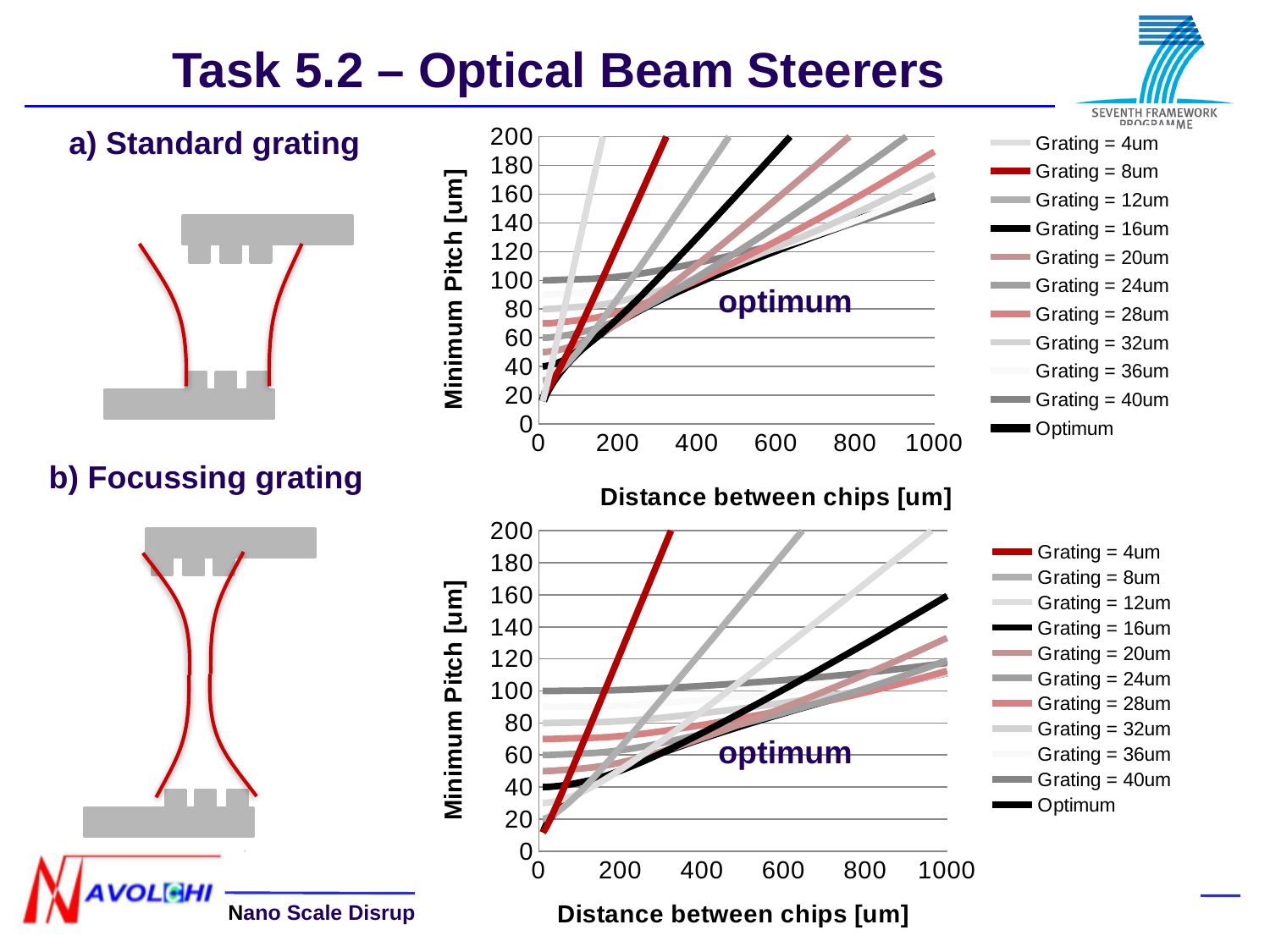
In the top chart, is the value for Grating = 8um at a distance of 200 greater or less than 100? greater In the top chart, does the Optimum line rise or fall as the distance between chips increases? rises What kind of chart is the top chart (Standard grating)? line chart In the bottom chart, is the value for Grating = 4um at a distance of 200 greater or less than 100? greater In the bottom chart, does the Optimum line rise or fall as the distance between chips increases? rises What is the x-axis title of the top chart? Distance between chips [um] In the bottom chart, at a distance of 1000, which is higher: Optimum or Grating = 40um? Grating = 40um In the top chart, is the value for Grating = 40um at a distance of 0 greater or less than 80? greater What is the y-axis title of the bottom chart? Minimum Pitch [um] How many series does the legend of the top chart list? 11 How many series does the legend of the bottom chart list? 11